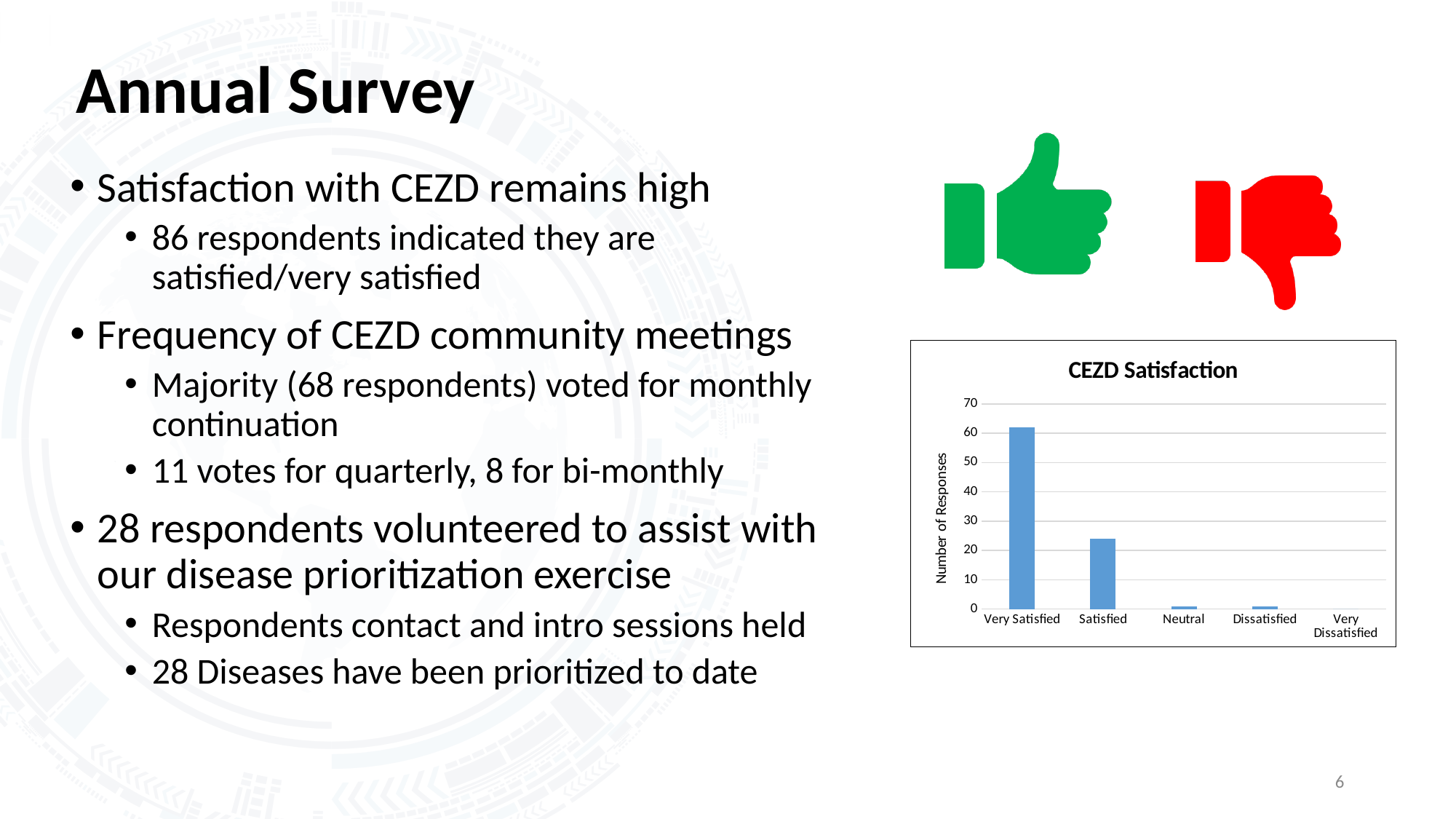
Is the value for Satisfied greater or less than 20? greater Is the value for Very Satisfied greater or less than 50? greater Is the value for Neutral greater or less than 10? less Which category has the highest number of responses? Very Satisfied What is the label on the vertical axis of the chart? Number of Responses What type of chart is shown on the slide? bar chart How many categories are shown on the x axis of the chart? 5 Which has more responses, Very Satisfied or Satisfied? Very Satisfied What is the title of the chart? CEZD Satisfaction Do the values generally rise or fall moving from Very Satisfied to Very Dissatisfied along the x axis? fall Which category has the lowest number of responses? Very Dissatisfied